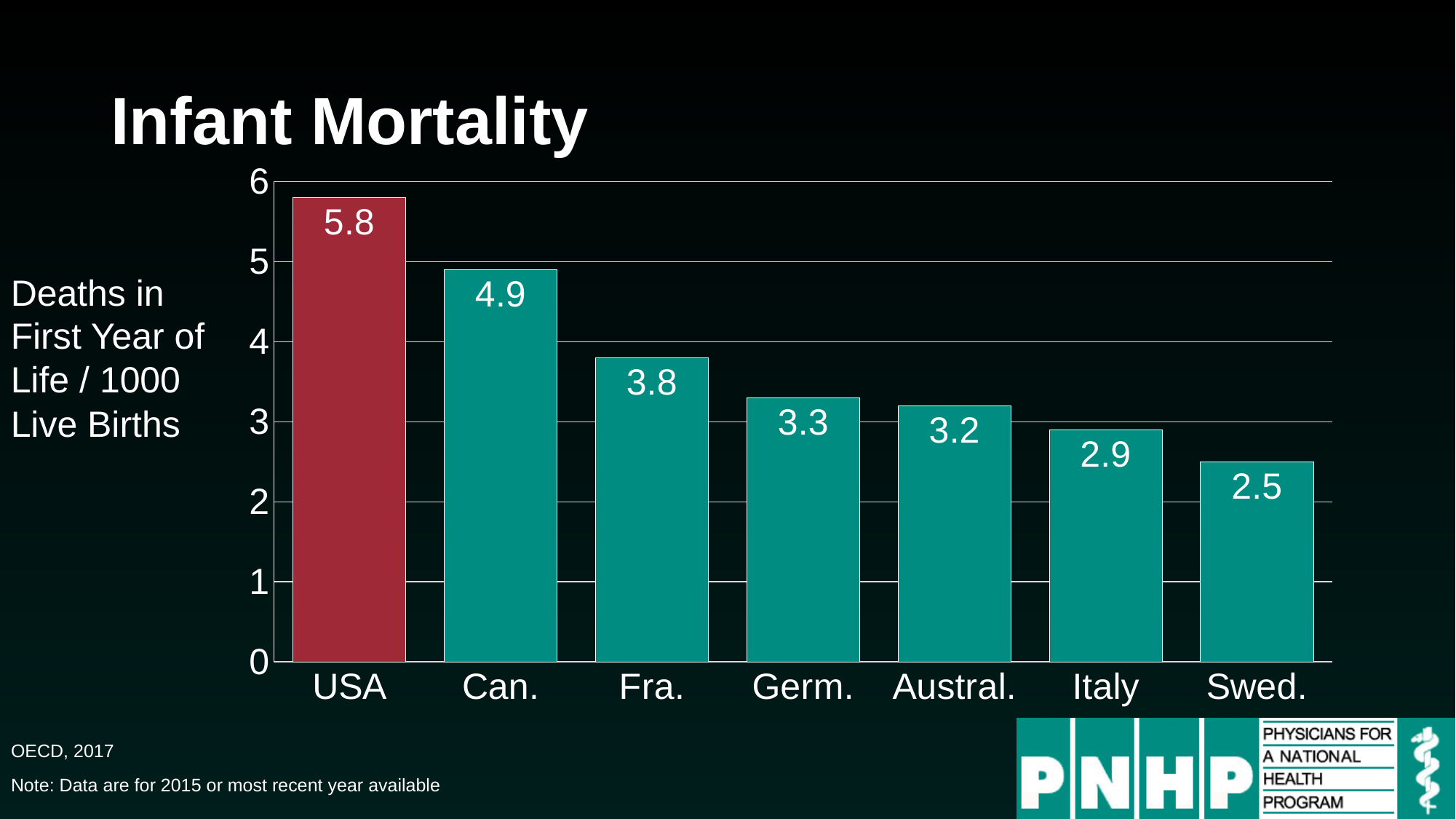
Which country has the lowest infant mortality on the chart? Swed. Which has a higher value, Can. or Fra.? Can. How many countries are shown on the chart? 7 What is the value shown for Germ.? 3.3 What is the difference between the values for Fra. and Italy? 0.9 What is the value shown for Swed.? 2.5 Which country has the highest infant mortality on the chart? USA Is the value for Austral. greater or less than 4? less What kind of chart is shown on the slide? bar chart Which bar is coloured differently from the others? USA What is the infant mortality value shown for the USA? 5.8 What is the difference between the values for the USA and Can.? 0.9